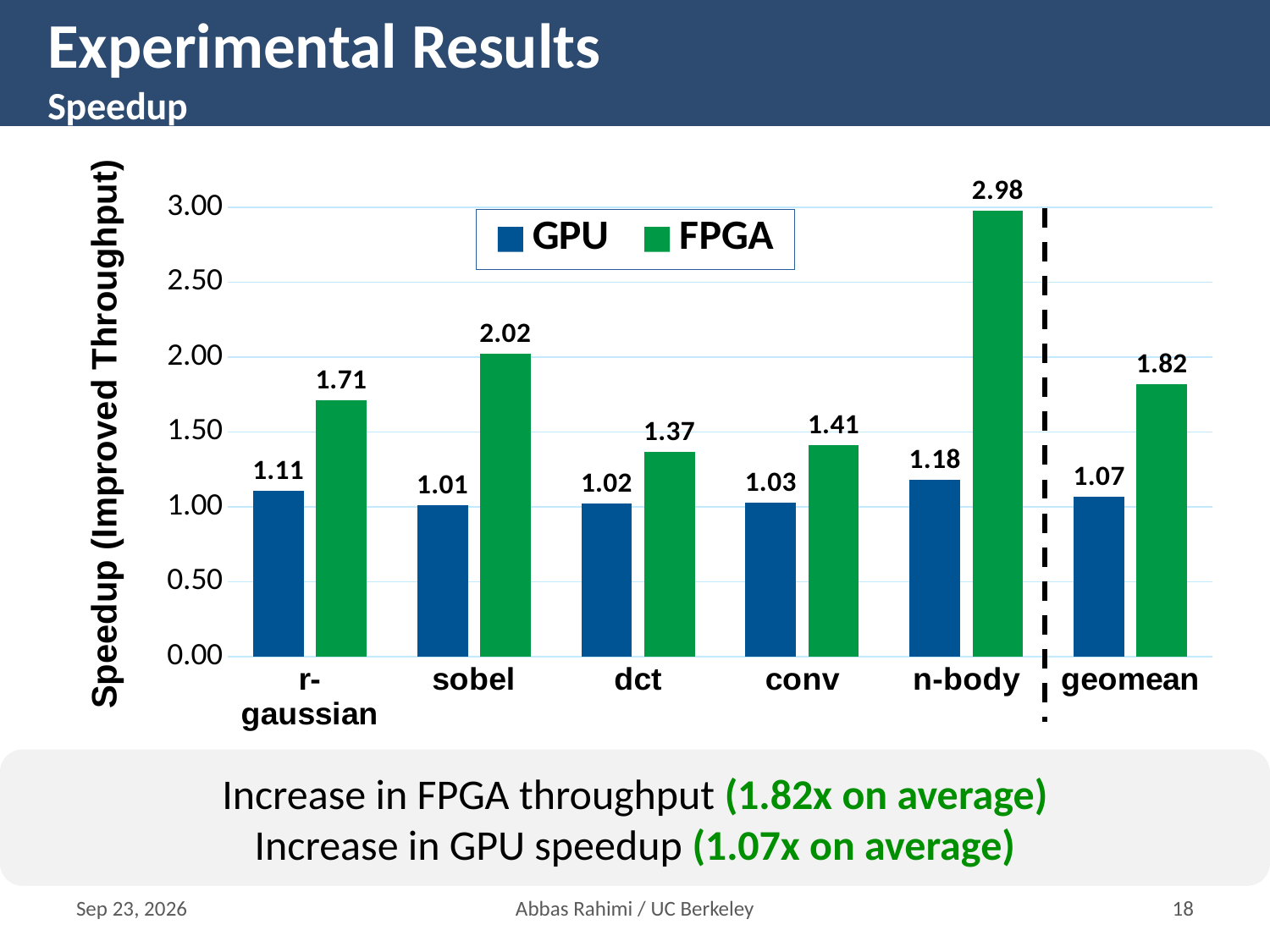
What is the FPGA speedup for n-body? 2.98 How many series does the legend list? 2 Which category has the highest FPGA speedup? n-body Which category has the lowest GPU speedup? sobel What is the difference between the FPGA and GPU speedup for dct? 0.35 Which is larger, the FPGA speedup for conv or the FPGA speedup for dct? FPGA speedup for conv What kind of chart is shown on the slide? Bar chart How many categories are shown on the x axis? 6 What is the GPU speedup for r-gaussian? 1.11 What is the y-axis label of the chart? Speedup (Improved Throughput) What is the FPGA speedup for sobel? 2.02 What is the GPU speedup for geomean? 1.07